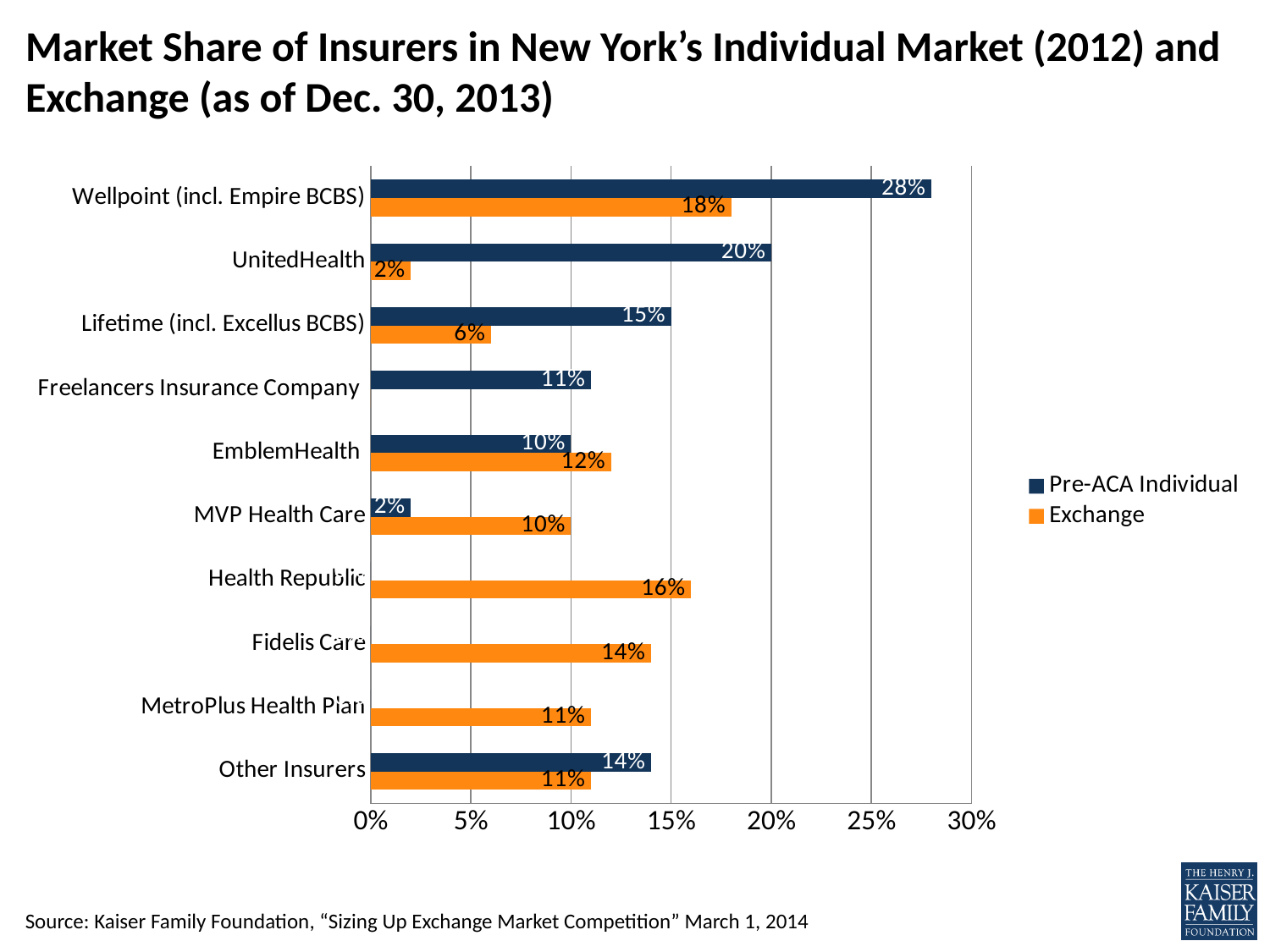
Is the Exchange market share for Fidelis Care greater or less than 10%? greater Which insurer has the highest Exchange market share? Wellpoint (incl. Empire BCBS) How many insurer categories are shown on the chart? 10 What is the Exchange market share for UnitedHealth? 2% Which insurer has the highest Pre-ACA Individual market share? Wellpoint (incl. Empire BCBS) What kind of chart is shown on the slide? Bar chart What is the Pre-ACA Individual market share for Freelancers Insurance Company? 11% What is the difference between Wellpoint's Pre-ACA Individual share and its Exchange share? 10% What is the Exchange market share for Health Republic? 16% What is the Pre-ACA Individual market share for Wellpoint (incl. Empire BCBS)? 28% Which is larger for EmblemHealth: the Pre-ACA Individual share or the Exchange share? Exchange How many series does the legend list? 2